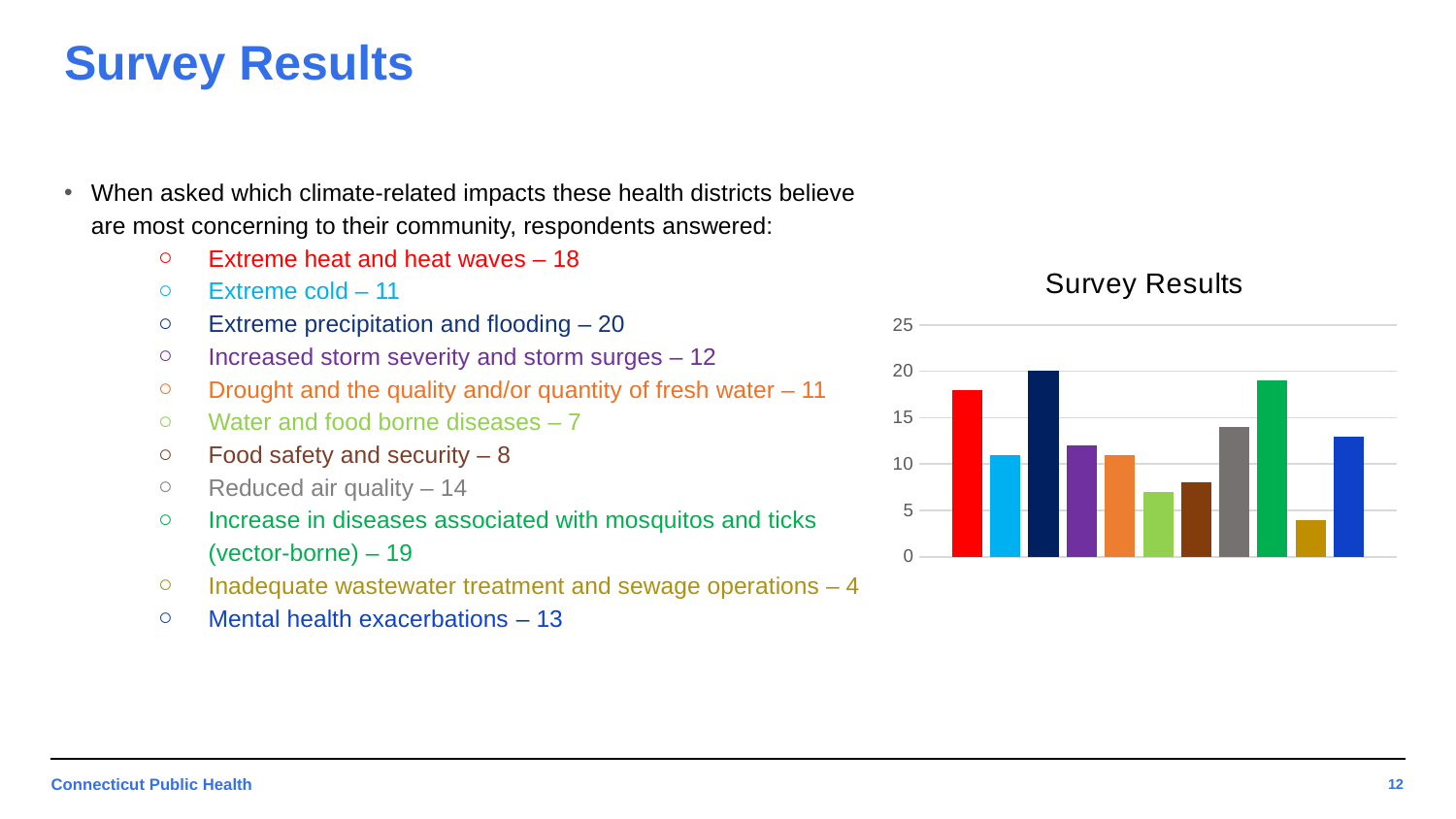
Is the value of the sixth (light green) bar greater or less than 10? less Which bar is the shortest in the chart? the tenth (gold) bar Which is larger, the first (red) bar or the second (light blue) bar? the first (red) bar Which bar is the tallest in the chart? the third (dark navy) bar What is the highest value shown on the chart's y axis? 25 How many bars are plotted in the chart? 11 What is the title of the chart? Survey Results Is the value of the tenth (gold) bar greater or less than 5? less What kind of chart is shown on the slide? bar chart What value does the tallest (dark navy) bar reach on the y axis? 20 Which is larger, the ninth (green) bar or the eleventh (blue) bar? the ninth (green) bar Is the value of the first (red) bar greater or less than 15? greater